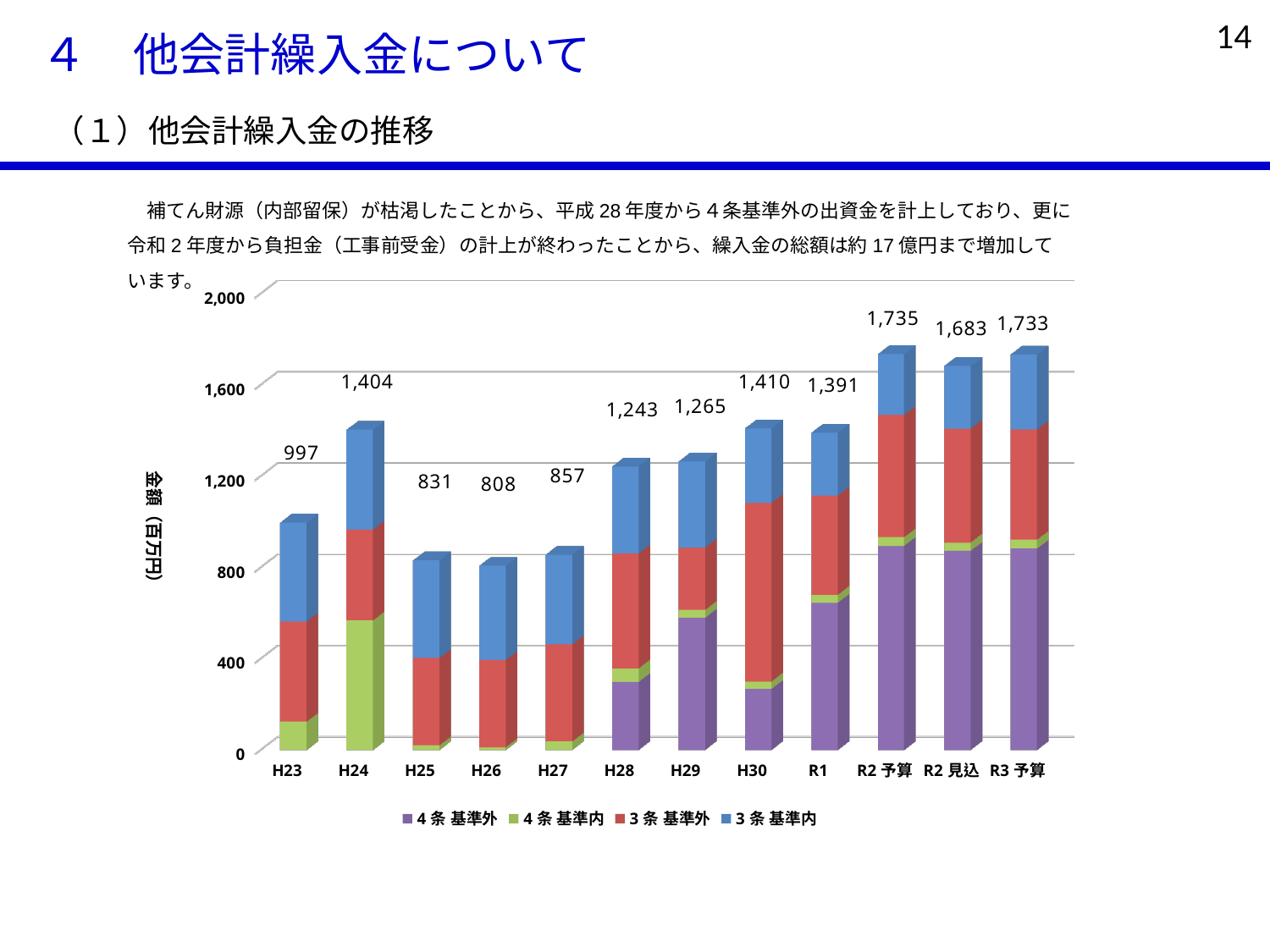
What is the total value labeled for H28? 1,243 How many series does the legend list? 4 Which has a larger total, H30 or R1? H30 What kind of chart is shown on the slide? stacked bar chart What is the difference between the totals for H24 and H23? 407 What is the total value labeled for R2 見込? 1,683 What is the total value labeled for H24? 1,404 How many categories are shown on the x axis? 12 Is the total for H25 greater or less than 1,200? less Which category has the highest total value? R2 予算 What is the label of the y axis? 金額（百万円） Which category has the lowest total value? H26